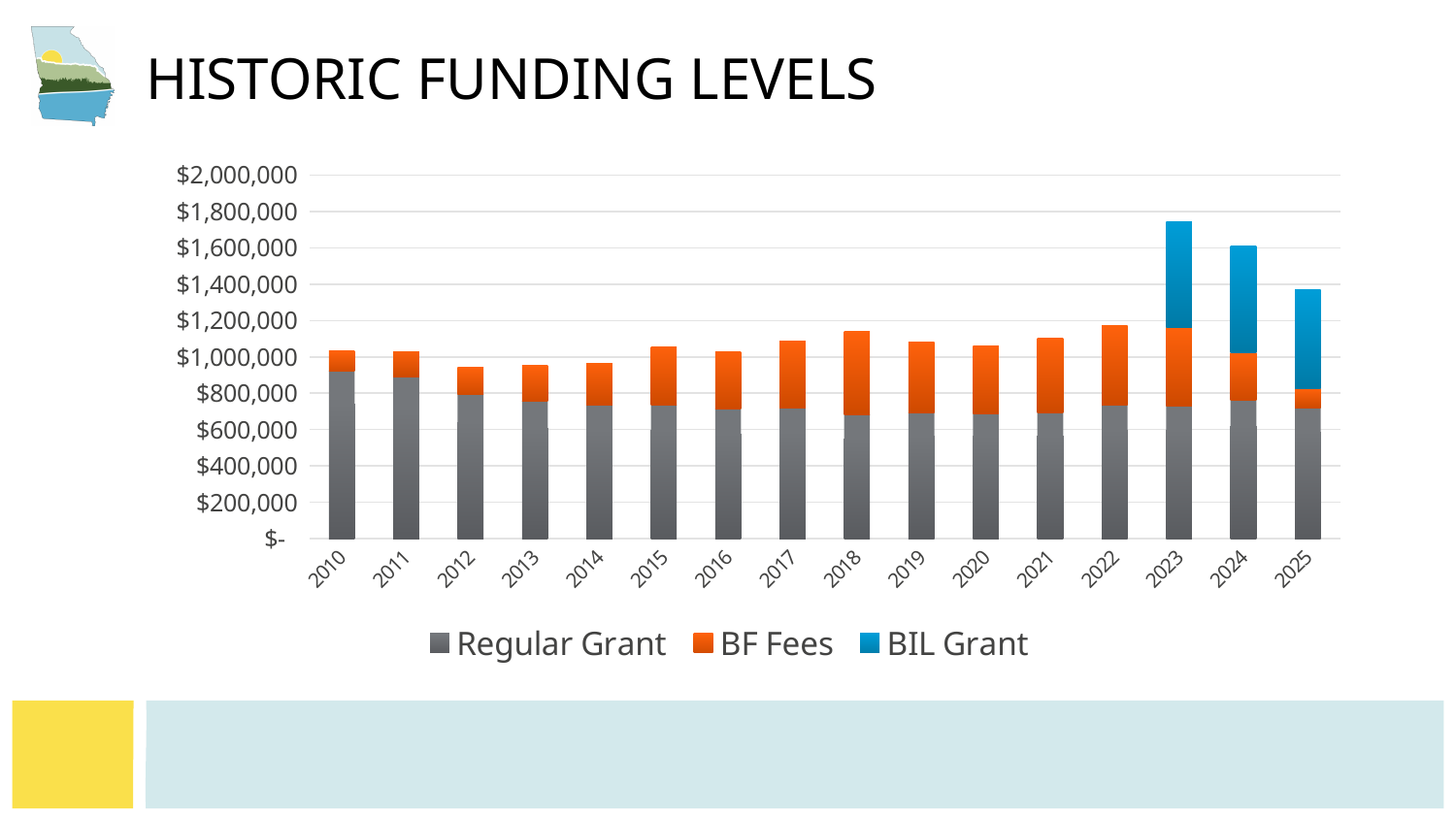
Is the total funding for 2022 greater or less than $1,000,000? greater Is the total funding for 2023 greater or less than $1,600,000? greater Is the total funding for 2024 greater or less than $1,400,000? greater What kind of chart is shown on the slide? Stacked bar chart What is the title of the chart? HISTORIC FUNDING LEVELS Do the total funding levels rise or fall from 2023 to 2025? fall Which year has the highest total funding? 2023 Which year has the larger total funding, 2023 or 2024? 2023 How many series does the legend list? 3 How many years are shown on the x axis? 16 Which series appears only in the bars for 2023, 2024 and 2025? BIL Grant